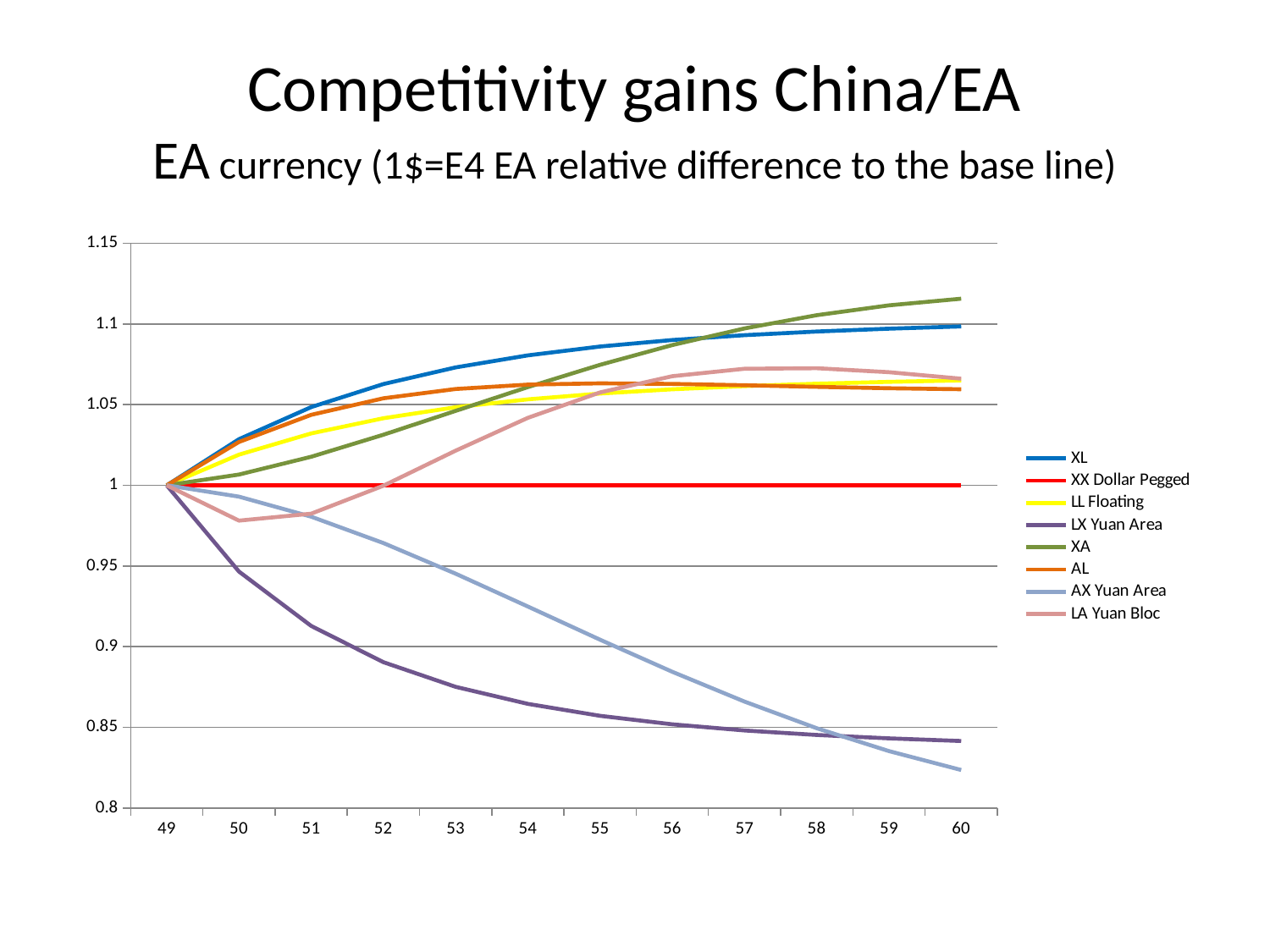
Which series has the lowest value at 60? AX Yuan Area What is the value of XL at 49? 1 How many points are there along the x axis? 12 What kind of chart is shown on the slide? line chart How many series does the legend list? 8 What is the value of XX Dollar Pegged at 60? 1 Do the values for AX Yuan Area rise or fall along the x axis? fall Is the value for XL at 60 greater or less than 1.05? greater Which series has the highest value at 60? XA At 60, which is larger: XL or LL Floating? XL Is the value for LX Yuan Area at 53 greater or less than 0.9? less What colour is the XX Dollar Pegged line? red